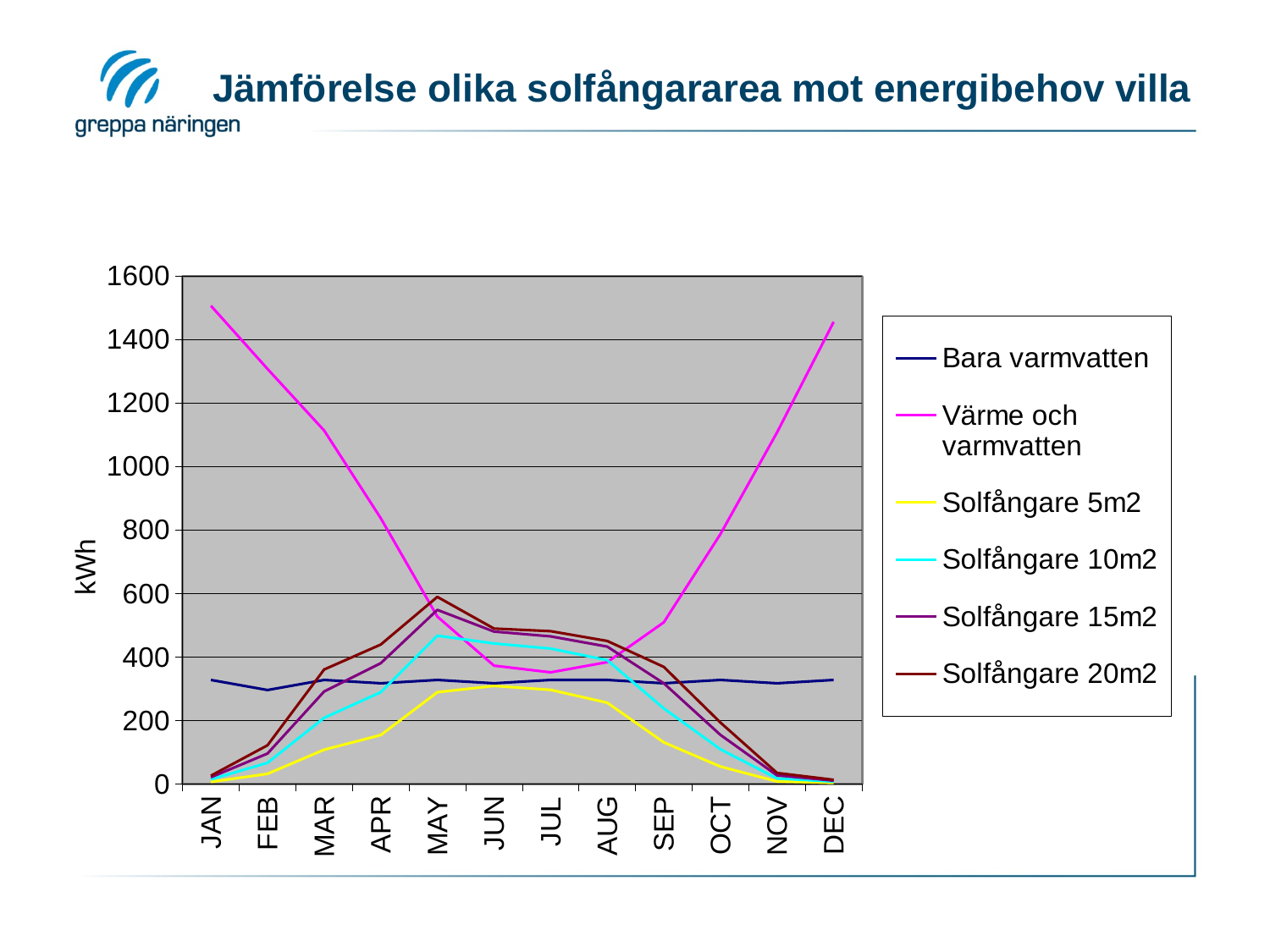
Is the value for Bara varmvatten in JAN greater or less than 400? less Does the Värme och varmvatten line rise or fall from JAN to JUL? fall How many months are shown along the x axis? 12 How many series does the legend list? 6 Is the value for Solfångare 20m2 in MAY greater or less than 400? greater What is the title of the slide containing the chart? Jämförelse olika solfångararea mot energibehov villa What is the label on the y axis? kWh What kind of chart is shown on the slide? line chart In MAY, which is higher: Solfångare 20m2 or Solfångare 5m2? Solfångare 20m2 In which month does Solfångare 20m2 reach its highest value? MAY Is the value for Värme och varmvatten in JAN greater or less than 1400? greater